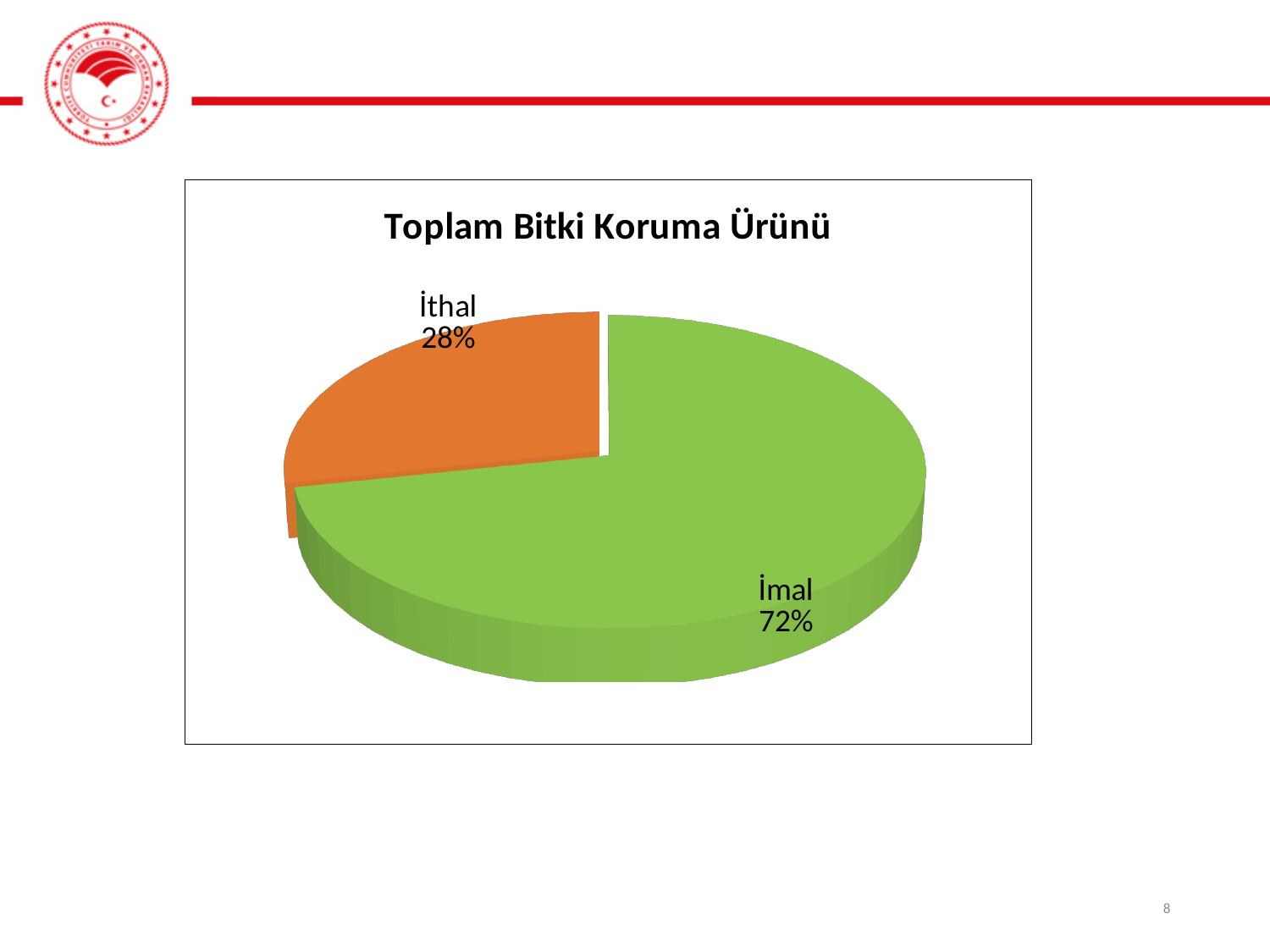
What colour is the İmal slice? green Is the share for İthal greater or less than 50%? less How many slices does the pie chart have? 2 What kind of chart is shown on the slide? pie chart What is the difference in percentage points between İmal and İthal? 44 What share of the pie does İmal represent? 72% Which is larger, İmal or İthal? İmal Which slice is the largest in the pie chart? İmal Which slice is the smallest in the pie chart? İthal What is the title of the chart? Toplam Bitki Koruma Ürünü What share of the pie does İthal represent? 28%